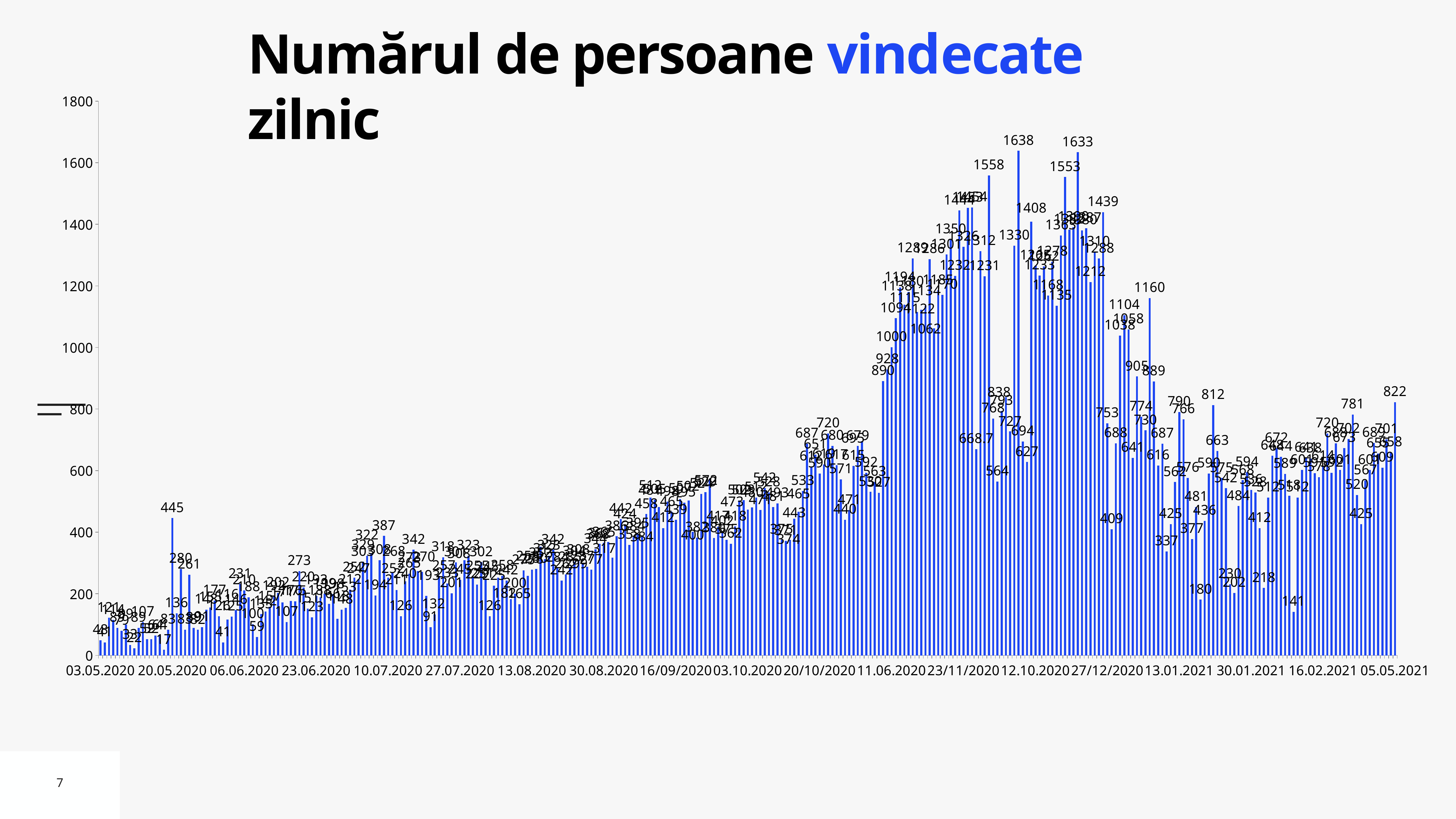
Is the tallest bar greater or less than 1600? greater Which is larger, the bar labeled 1638 or the bar labeled 1439? 1638 What is the title of the chart? Numărul de persoane vindecate zilnic What is the highest daily value labeled on the chart? 1638 Do the values generally rise or fall from 03.05.2020 to 23/11/2020? rise What is the maximum value shown on the vertical axis? 1800 What is the difference between the two highest labeled values, 1638 and 1633? 5 What is the difference between the highest value (1638) and the last bar's value (822)? 816 What is the value of the last bar, for 05.05.2021? 822 What is the value of the tallest bar in May 2020, near the 20.05.2020 label? 445 What is the lowest labeled value on the chart? 17 What kind of chart is shown on the slide? bar chart